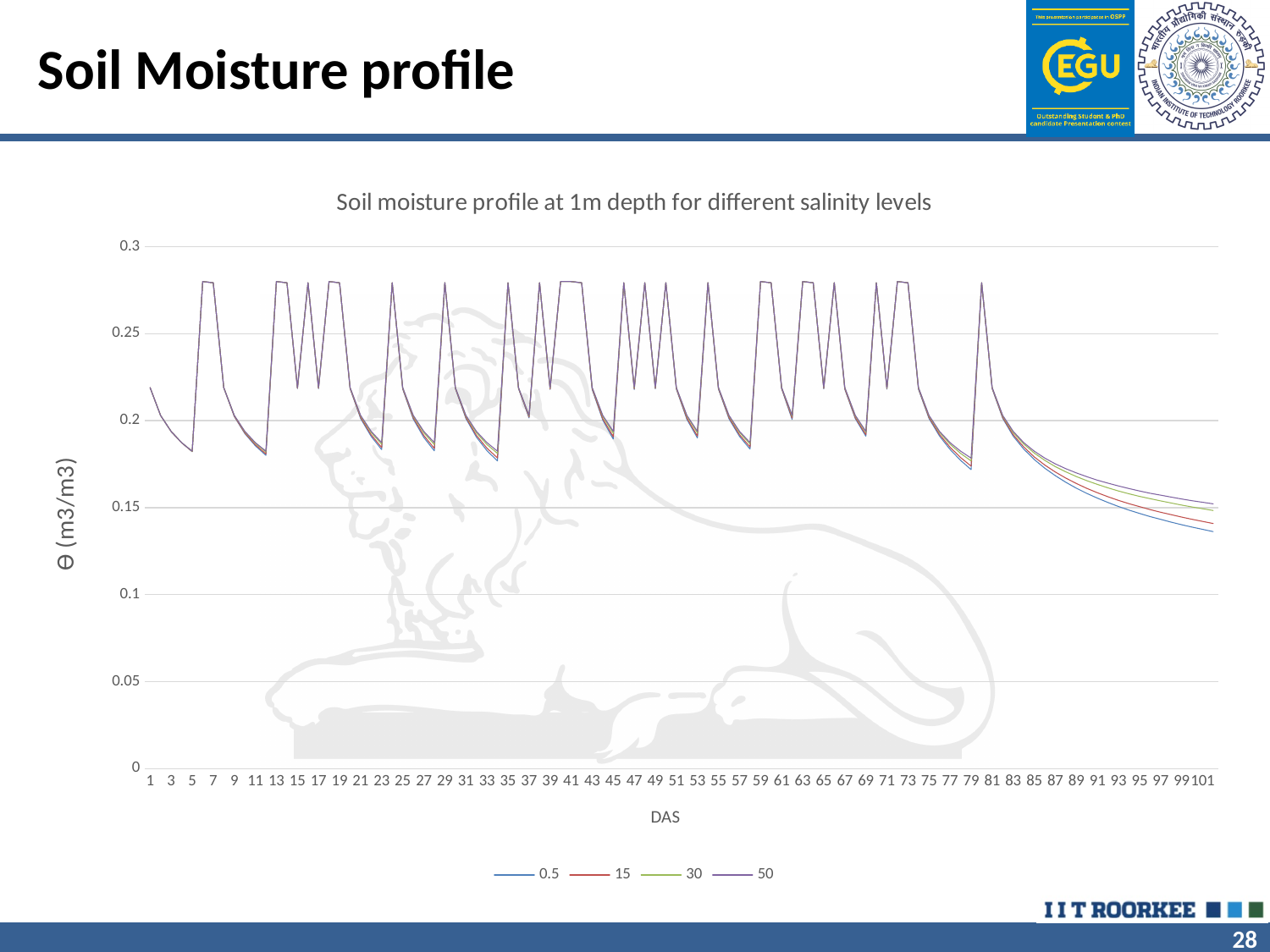
At DAS 1, is the value greater or less than 0.2? greater How many series does the legend list? 4 At DAS 101, which series has the highest value? 50 After the last peak around DAS 81, do the values rise or fall toward DAS 101? fall What is the title of the chart? Soil moisture profile at 1m depth for different salinity levels What are the series names listed in the legend? 0.5, 15, 30, 50 Are the lowest trough values between irrigation peaks greater or less than 0.2? less What kind of chart is shown on the slide? line chart At DAS 101, is the value for the 0.5 series greater or less than 0.15? less At DAS 101, which series has the higher value, 0.5 or 50? 50 At DAS 101, which series has the lowest value? 0.5